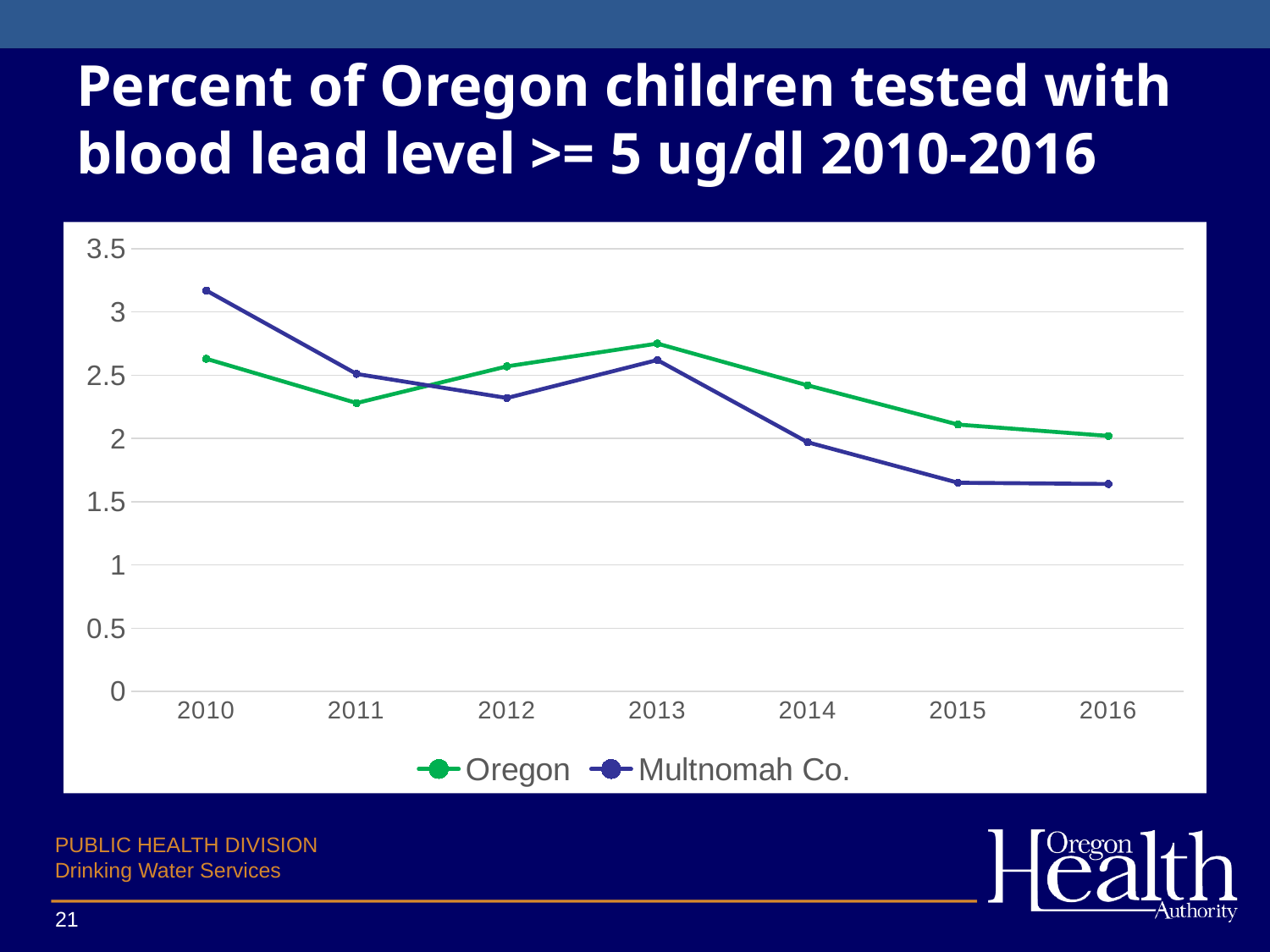
Does the Multnomah Co. line rise or fall from 2013 to 2016? Fall How many series does the legend list? 2 What is the title of the chart? Percent of Oregon children tested with blood lead level >= 5 ug/dl 2010-2016 What kind of chart is shown on the slide? Line chart Is the value for Oregon in 2011 greater or less than 2.5? less Which series is shown in green in the legend? Oregon How many years are plotted along the x axis? 7 In 2010, which series has the higher value, Oregon or Multnomah Co.? Multnomah Co. Is the value for Multnomah Co. in 2015 greater or less than 2? less Is the value for Oregon in 2013 greater or less than 2.5? greater In which year is the Multnomah Co. value highest? 2010